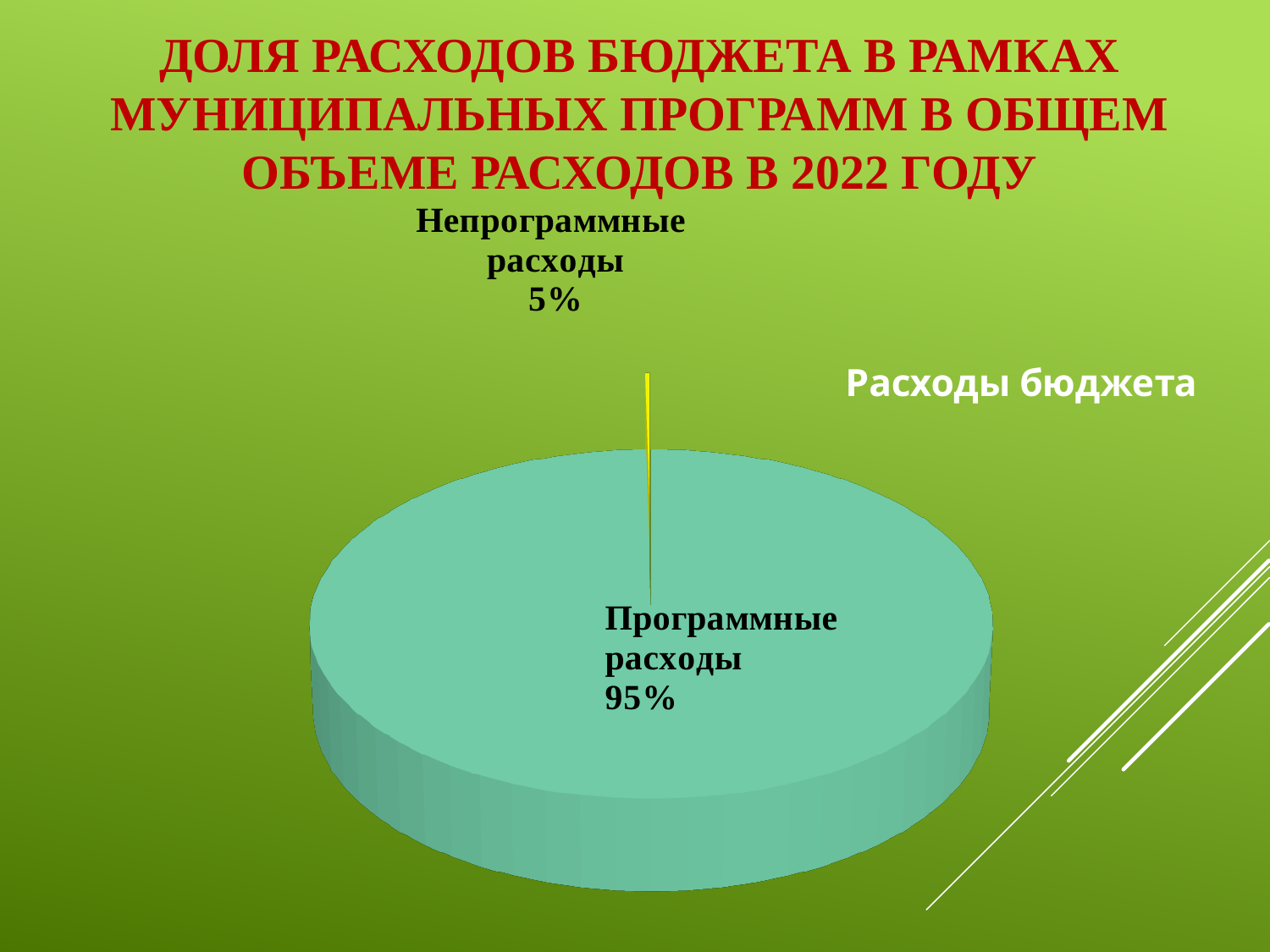
What share of the pie is labelled "Программные расходы"? 95% What is the total of the two slices shown in the pie chart? 100% Which slice of the pie is the smallest? Непрограммные расходы Which slice of the pie is the largest? Программные расходы What share of the pie is labelled "Непрограммные расходы"? 5% What colour is the "Непрограммные расходы" slice? yellow What is the difference in percentage points between "Программные расходы" and "Непрограммные расходы"? 90 What kind of chart is shown on the slide? pie chart What is the title of the chart? Расходы бюджета Which is larger: "Программные расходы" or "Непрограммные расходы"? Программные расходы How many slices does the pie chart have? 2